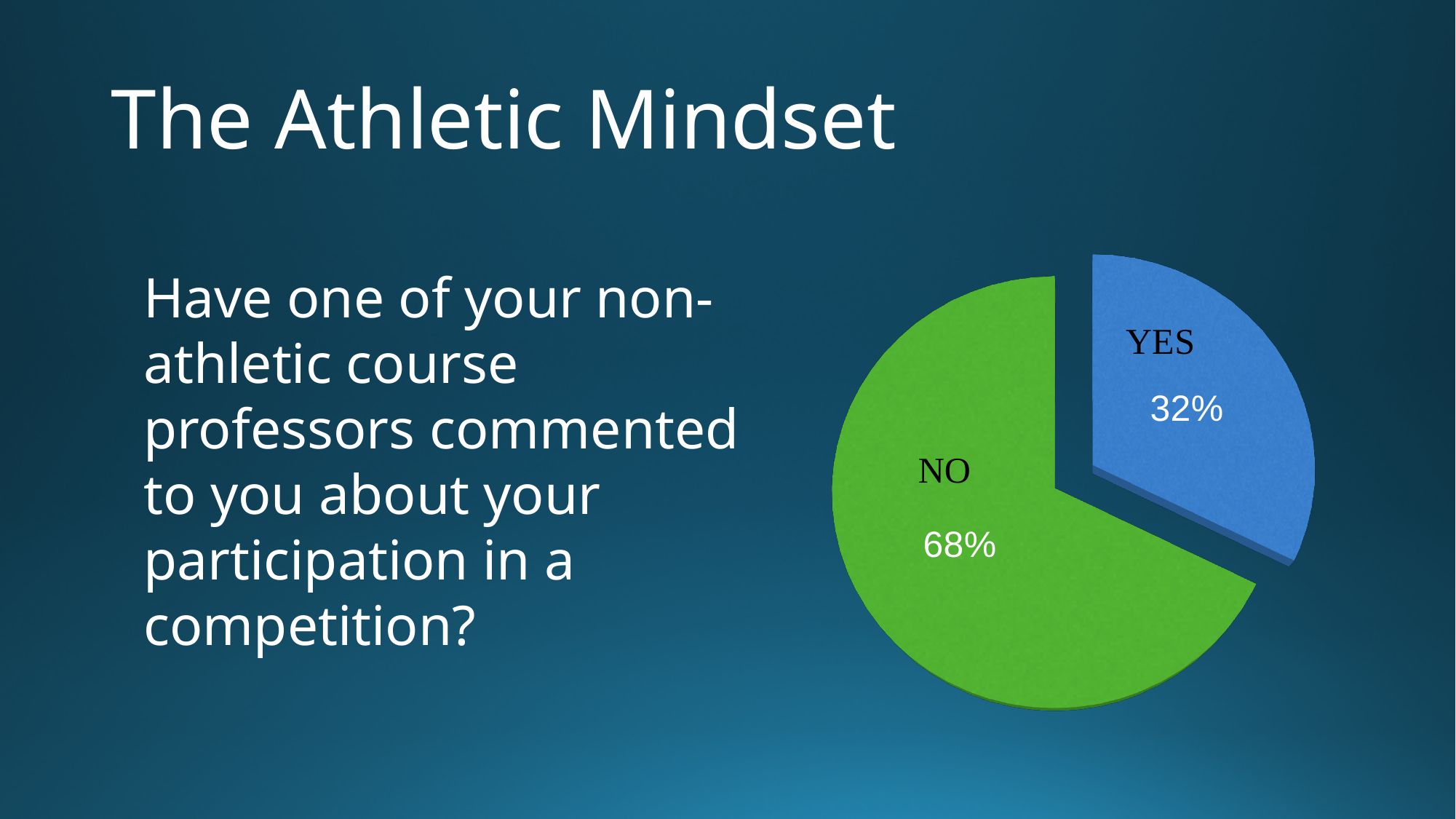
What percentage of the pie chart is labelled YES? 32% What colour is the YES slice of the pie chart? Blue What is the difference in percentage points between the NO slice and the YES slice? 36 What percentage of the pie chart is labelled NO? 68% How many slices does the pie chart have? 2 Which slice of the pie chart is the smallest? YES What colour is the NO slice of the pie chart? Green What kind of chart is shown on the slide? Pie chart Which slice of the pie chart is the largest? NO What share of the pie does the YES slice represent? 32% Which slice is larger, YES or NO? NO